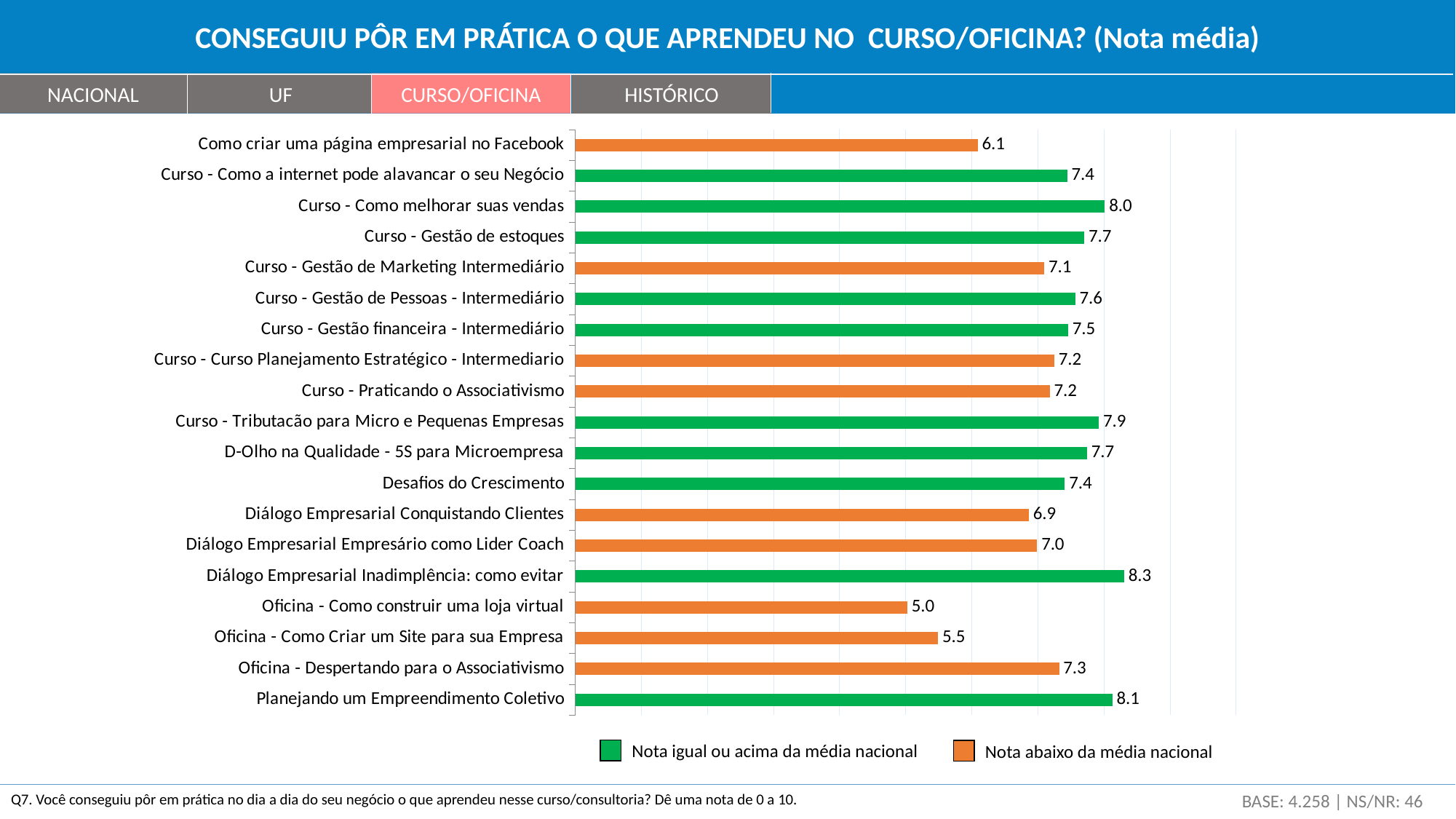
Which has a higher score: "Curso - Gestão de estoques" or "Curso - Gestão de Marketing Intermediário"? Curso - Gestão de estoques What type of chart is shown on the slide? Bar chart What is the difference between the scores for "Planejando um Empreendimento Coletivo" and "Como criar uma página empresarial no Facebook"? 2.0 Which course/workshop has the lowest average score? Oficina - Como construir uma loja virtual What is the average score for "Diálogo Empresarial Conquistando Clientes"? 6.9 How many entries does the legend list? 2 What is the average score for "Oficina - Como Criar um Site para sua Empresa"? 5.5 What does the orange colour in the legend represent? Nota abaixo da média nacional How many bars are coloured green (score equal to or above the national average)? 10 How many courses/workshops are shown in the chart? 19 What is the average score for "Curso - Como melhorar suas vendas"? 8.0 Which course/workshop has the highest average score? Diálogo Empresarial Inadimplência: como evitar